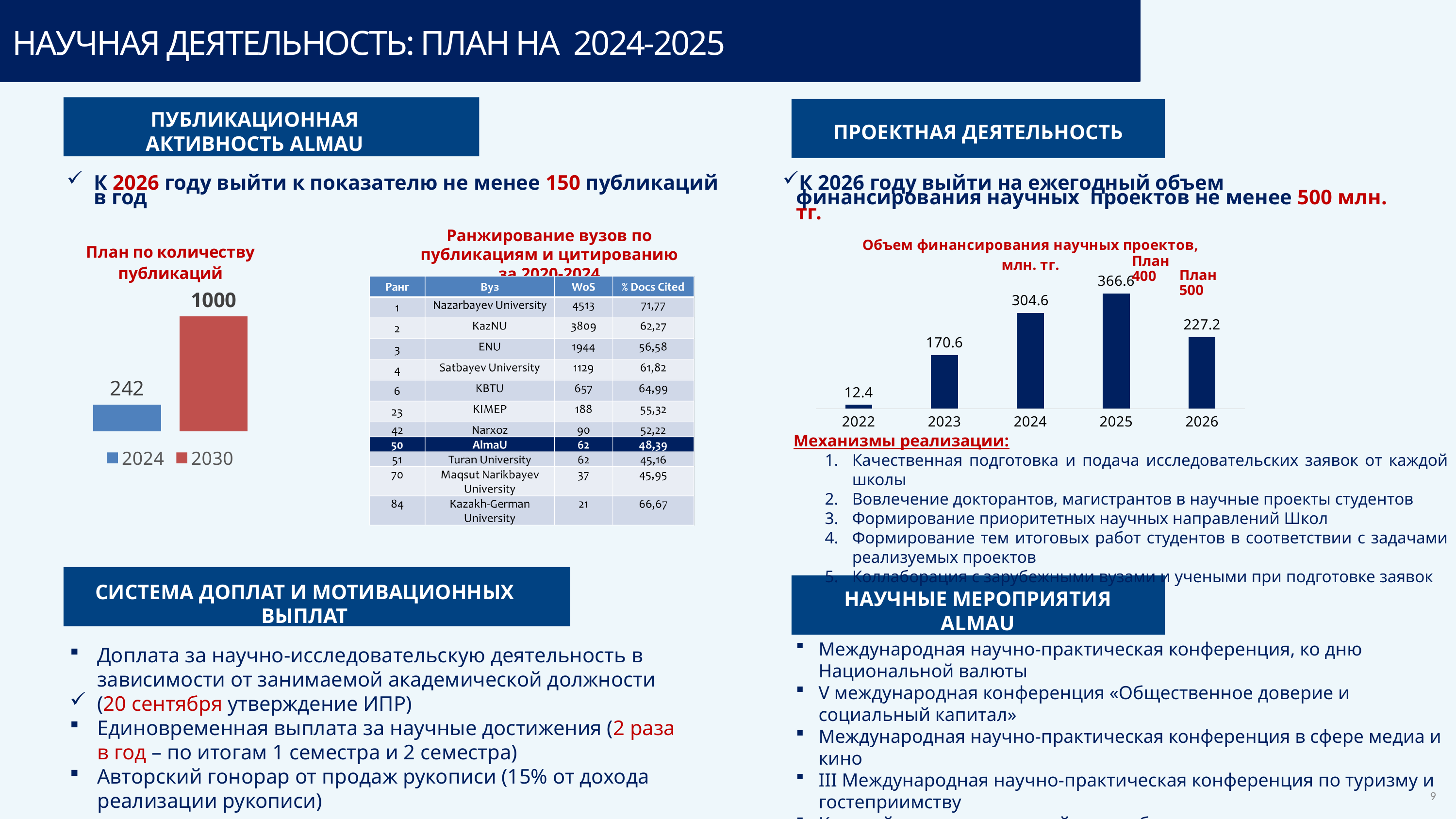
In the chart 'Объем финансирования научных проектов, млн. тг.', what is the difference between the 2024 and 2023 values? 134.0 In the chart 'Объем финансирования научных проектов, млн. тг.', what is the value for 2022? 12.4 In the chart 'Объем финансирования научных проектов, млн. тг.', which year has the lowest value? 2022 In the chart 'Объем финансирования научных проектов, млн. тг.', what is the value for 2023? 170.6 In the chart 'План по количеству публикаций', how many series does the legend list? 2 In the chart 'Объем финансирования научных проектов, млн. тг.', which is larger, the value for 2024 or the value for 2026? 2024 In the chart 'Объем финансирования научных проектов, млн. тг.', which year has the highest value? 2025 In the chart 'Объем финансирования научных проектов, млн. тг.', how many years are shown on the x axis? 5 In the chart 'План по количеству публикаций', what is the value for 2030? 1000 In the chart 'План по количеству публикаций', what is the difference between the 2030 and 2024 values? 758 What kind of chart is 'План по количеству публикаций'? Bar chart In the chart 'План по количеству публикаций', what is the value for 2024? 242